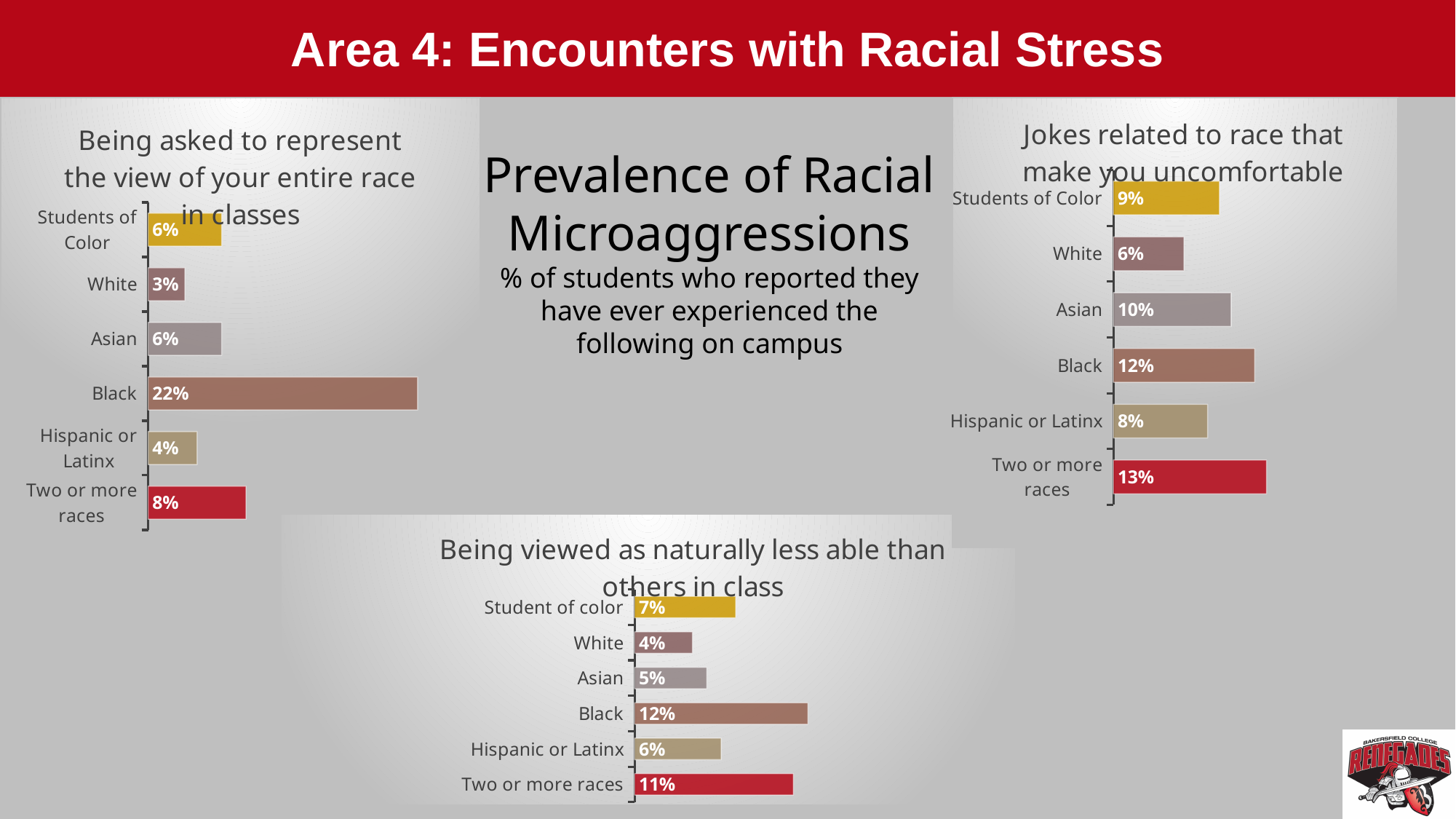
In the chart titled 'Jokes related to race that make you uncomfortable', what is the value for Asian? 10% In the chart titled 'Jokes related to race that make you uncomfortable', which category has the highest value? Two or more races What kind of chart is the chart titled 'Being viewed as naturally less able than others in class'? Bar chart In the chart titled 'Being asked to represent the view of your entire race in classes', which category has the highest value? Black In the chart titled 'Being asked to represent the view of your entire race in classes', what is the difference between the values for Black and Two or more races? 14% In the chart titled 'Being asked to represent the view of your entire race in classes', what is the value for Black? 22% In the chart titled 'Being viewed as naturally less able than others in class', which category has the lowest value? White In the chart titled 'Jokes related to race that make you uncomfortable', how many categories are shown? 6 In the chart titled 'Jokes related to race that make you uncomfortable', which is larger, the value for Black or the value for Hispanic or Latinx? Black In the chart titled 'Being asked to represent the view of your entire race in classes', which category has the lowest value? White In the chart titled 'Being viewed as naturally less able than others in class', what is the difference between the values for Black and Asian? 7% In the chart titled 'Being viewed as naturally less able than others in class', what is the value for Two or more races? 11%